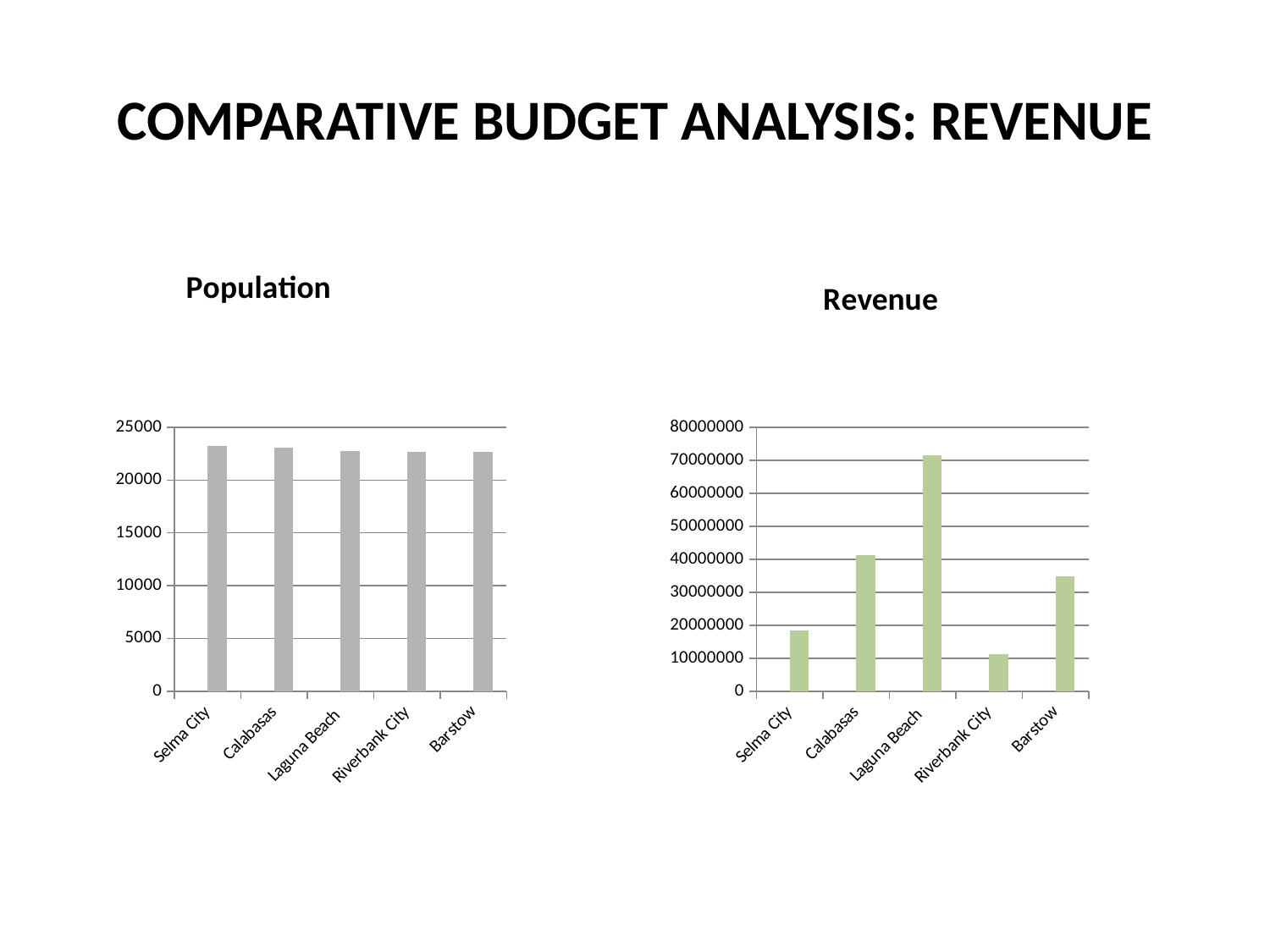
In the Revenue chart, is the value for Laguna Beach greater or less than 70000000? greater In the Revenue chart, is the value for Barstow greater or less than 40000000? less What is the title of the chart on the right side of the slide? Revenue In the Population chart, is the value for Selma City greater or less than 20000? greater What kind of chart is the Population chart? bar chart How many cities are shown in the Revenue chart? 5 In the Revenue chart, which has the larger revenue, Calabasas or Barstow? Calabasas In the Revenue chart, which has the larger revenue, Selma City or Riverbank City? Selma City In the Revenue chart, which city has the lowest revenue? Riverbank City In the Revenue chart, which city has the highest revenue? Laguna Beach